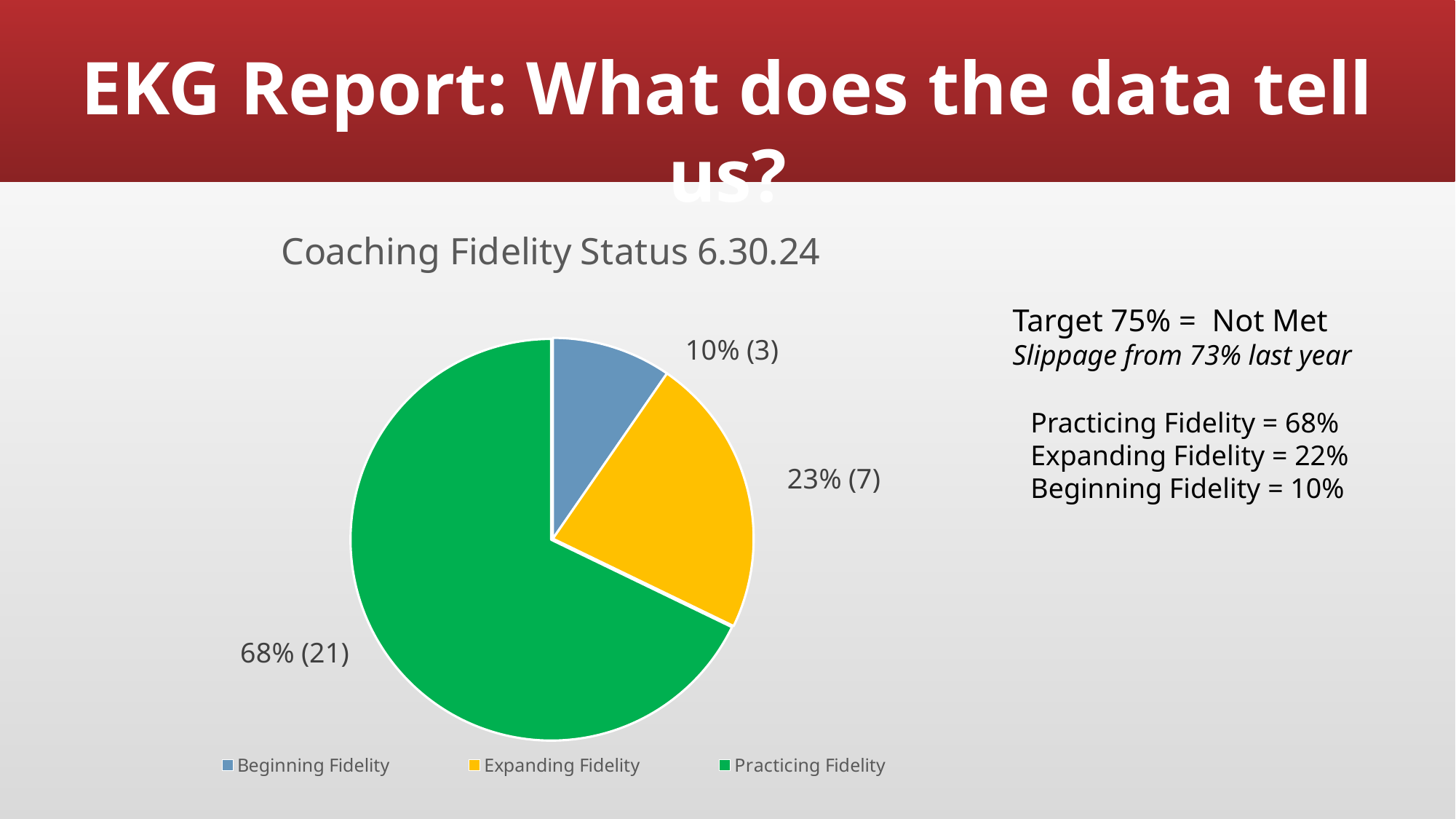
What type of chart is shown on the slide? pie chart What colour is the Practicing Fidelity slice? green Which category has the smallest slice of the pie? Beginning Fidelity What is the title of the chart? Coaching Fidelity Status 6.30.24 What is the difference in count between the Practicing Fidelity slice (21) and the Expanding Fidelity slice (7)? 14 Which slice is larger, Expanding Fidelity or Beginning Fidelity? Expanding Fidelity What percentage label is shown for the Practicing Fidelity slice? 68% What count is shown in parentheses for the Expanding Fidelity slice? 7 How many entries does the chart legend list? 3 How many slices does the pie chart have? 3 What percentage label is shown for the Beginning Fidelity slice? 10% Which category has the largest slice of the pie? Practicing Fidelity